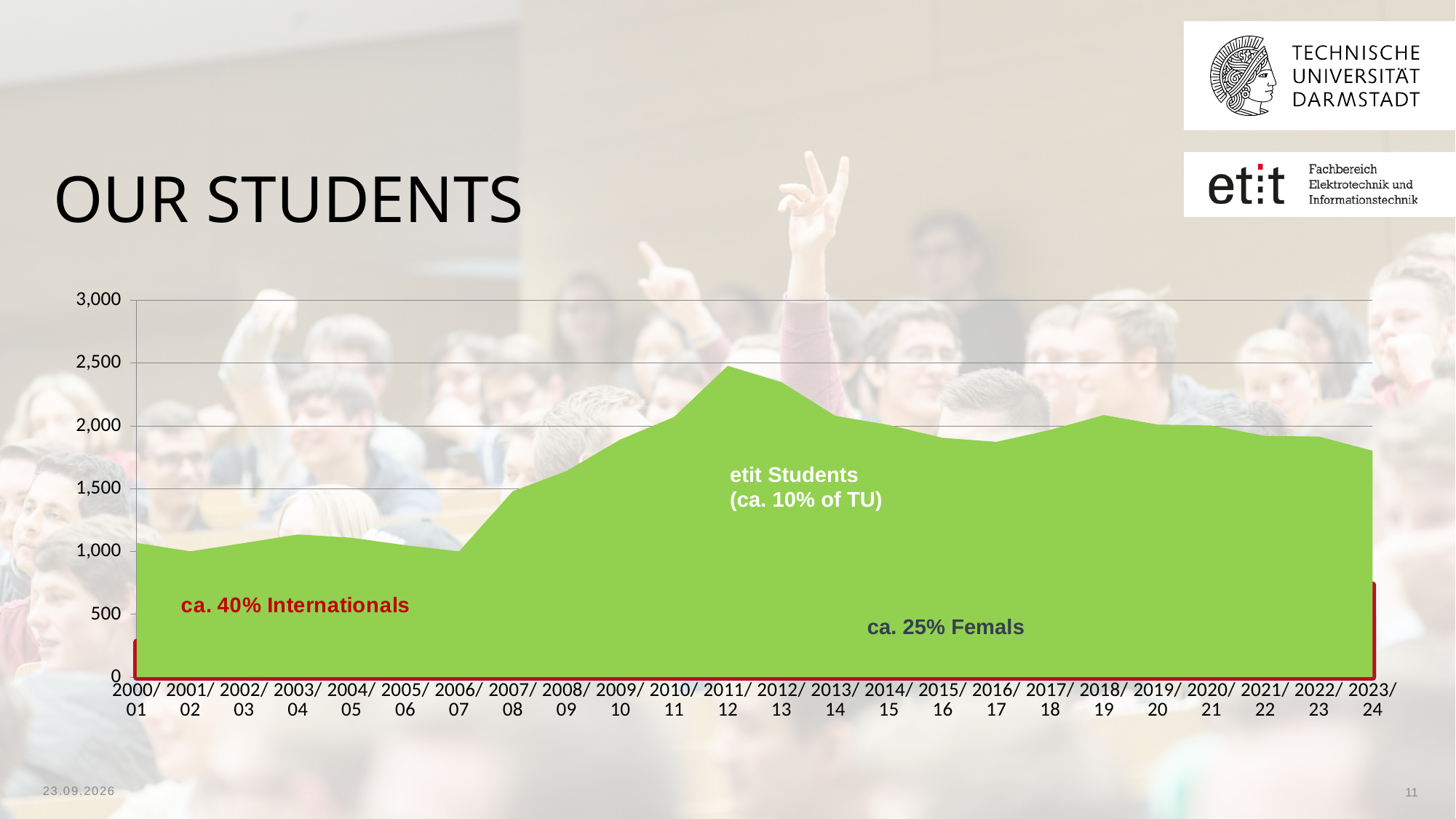
Which is larger, the value for 2011/12 or the value for 2000/01? 2011/12 Do the values rise or fall from 2011/12 to 2016/17? fall Is the value for 2011/12 greater or less than 2,000? greater According to the annotation on the chart, what share of etit students are internationals? ca. 40% What kind of chart is shown on the slide? area chart In which academic year is the number of etit students highest? 2011/12 According to the annotation on the chart, etit students make up roughly what share of TU? ca. 10% Is the value for 2009/10 greater or less than 1,500? greater How many academic years are plotted along the x axis? 24 Is the value for 2006/07 greater or less than 1,500? less Do the values rise or fall from 2006/07 to 2011/12? rise